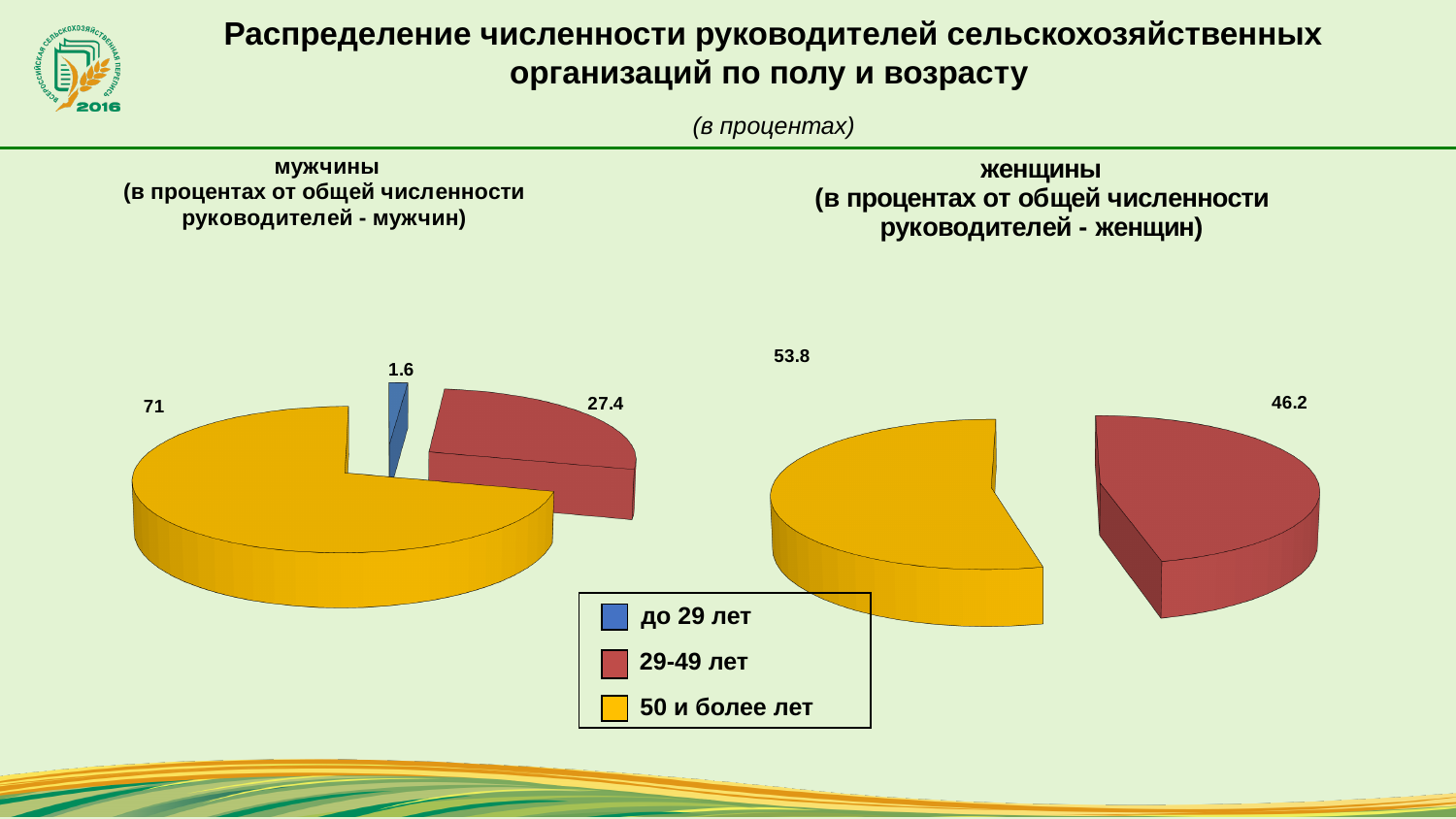
How many entries does the legend list? 3 On the left chart (мужчины), what is the value for the 'до 29 лет' slice? 1.6 On the right chart (женщины), what is the difference between the '50 и более лет' and '29-49 лет' values? 7.6 On the right chart (женщины), which age group has the larger share? 50 и более лет On the left chart (мужчины), what is the value for the '50 и более лет' slice? 71 On the right chart (женщины), what is the value for the '50 и более лет' slice? 53.8 On the left chart (мужчины), which age group has the smallest share? до 29 лет On the right chart (женщины), what is the value for the '29-49 лет' slice? 46.2 On the left chart (мужчины), which age group has the largest share? 50 и более лет What type of chart is used on this slide? Pie chart On the left chart (мужчины), what is the value for the '29-49 лет' slice? 27.4 On the left chart (мужчины), what is the difference between the '50 и более лет' and '29-49 лет' values? 43.6